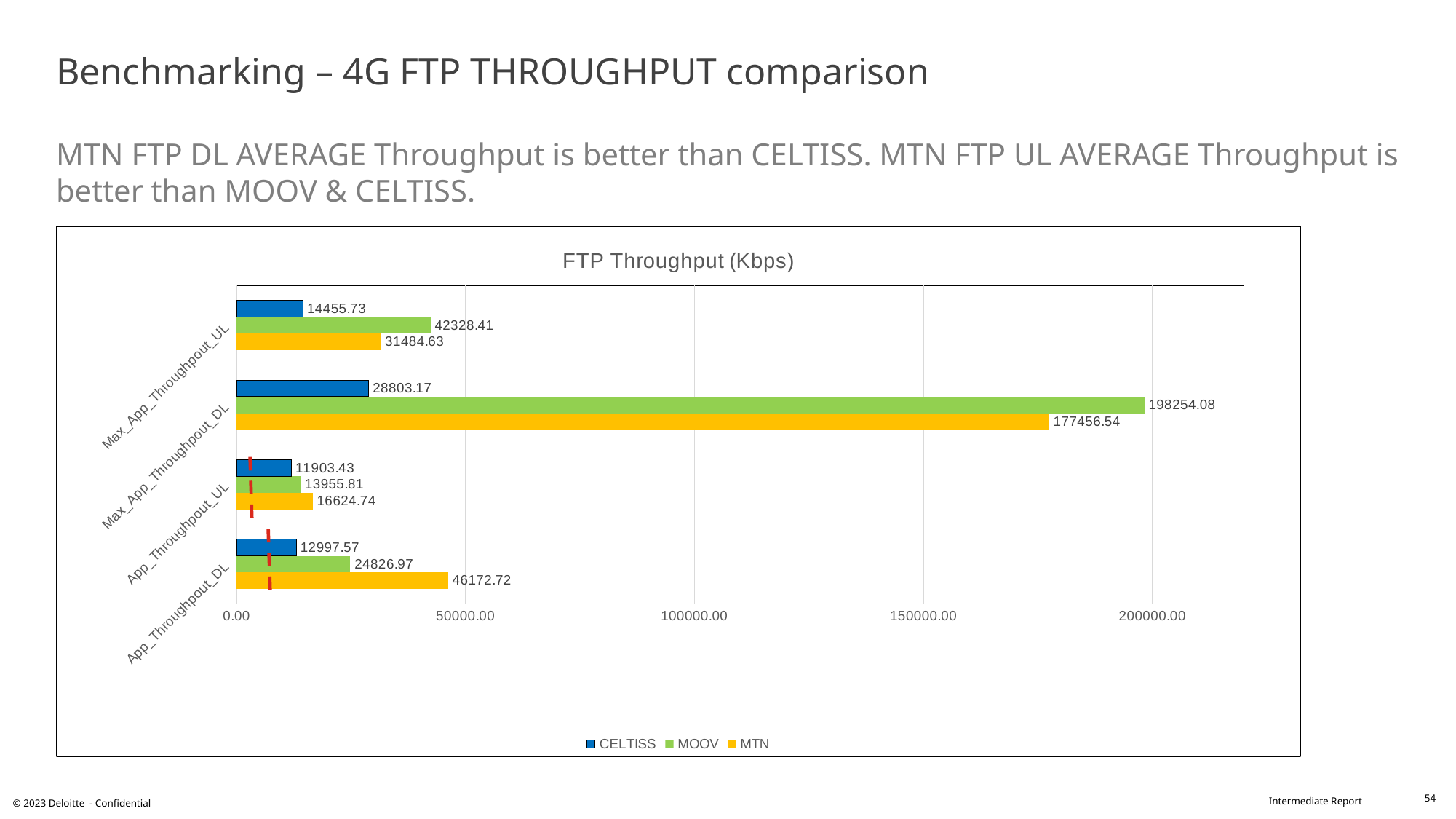
What is the MTN value for Max_App_Throughpout_UL? 31484.63 What is the MOOV value for Max_App_Throughpout_DL? 198254.08 What is the difference between the MTN and MOOV values for App_Throughpout_DL? 21345.75 What kind of chart is shown on the slide? Bar chart What is the CELTISS value for App_Throughpout_UL? 11903.43 What is the MTN value for App_Throughpout_DL? 46172.72 Which operator has the lowest value for App_Throughpout_DL? CELTISS How many categories are shown on the chart? 4 Which operator has the highest value for Max_App_Throughpout_UL? MOOV How many series does the legend list? 3 What is the difference between the MOOV and MTN values for Max_App_Throughpout_DL? 20797.54 For App_Throughpout_UL, which is larger: the MTN value or the CELTISS value? MTN